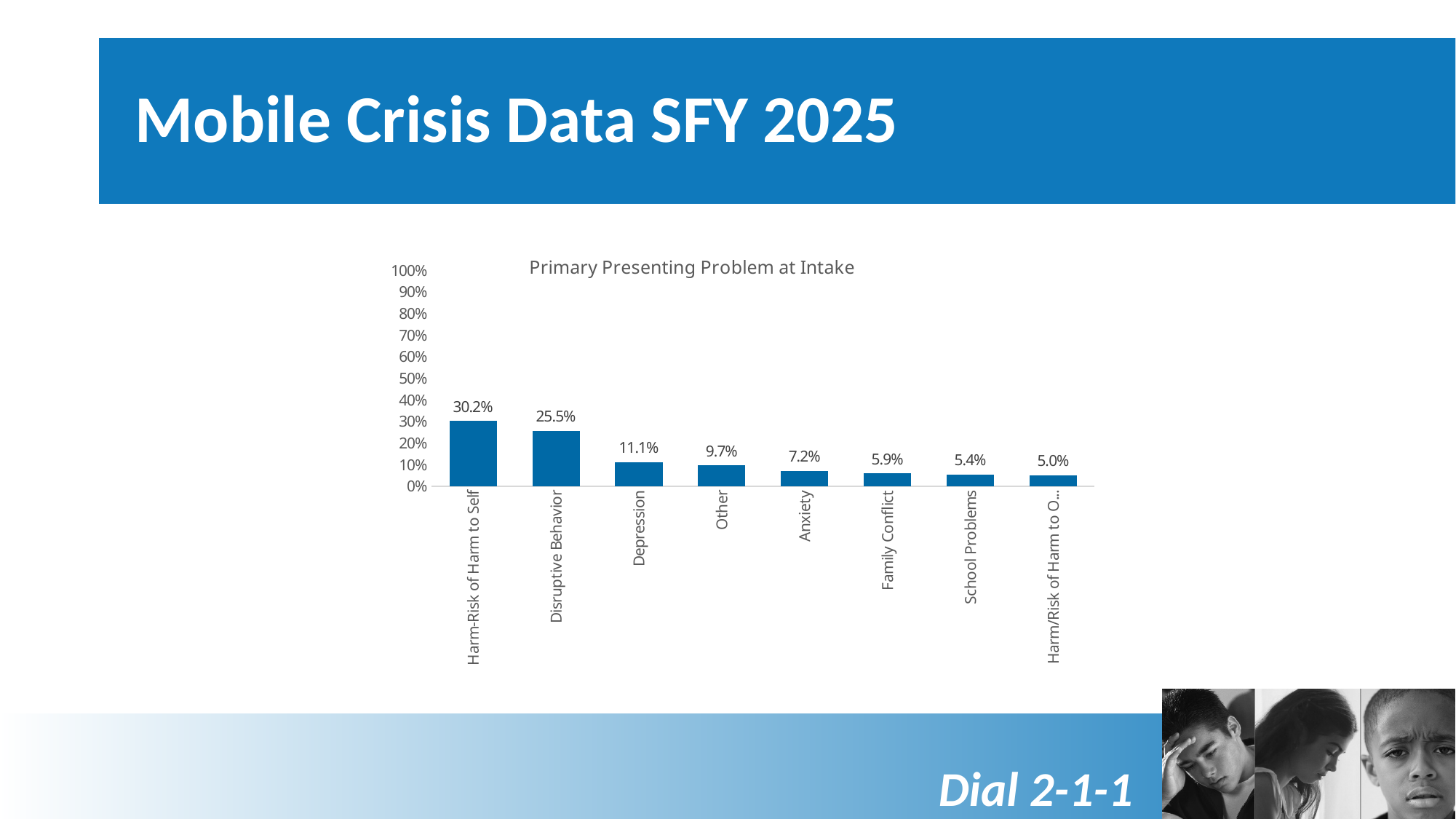
Which category has the lowest value? Harm/Risk of Harm to O... What is the difference between the values for Harm-Risk of Harm to Self and Disruptive Behavior? 4.7% What is the value for School Problems? 5.4% What kind of chart is shown on the slide? Bar chart How many categories are shown in the chart? 8 What is the value for Depression? 11.1% What is the value for Disruptive Behavior? 25.5% Which category has the highest value? Harm-Risk of Harm to Self What is the value for Harm-Risk of Harm to Self? 30.2% What is the value for Anxiety? 7.2% What is the title of the chart? Primary Presenting Problem at Intake Which is larger, the value for Other or the value for Family Conflict? Other